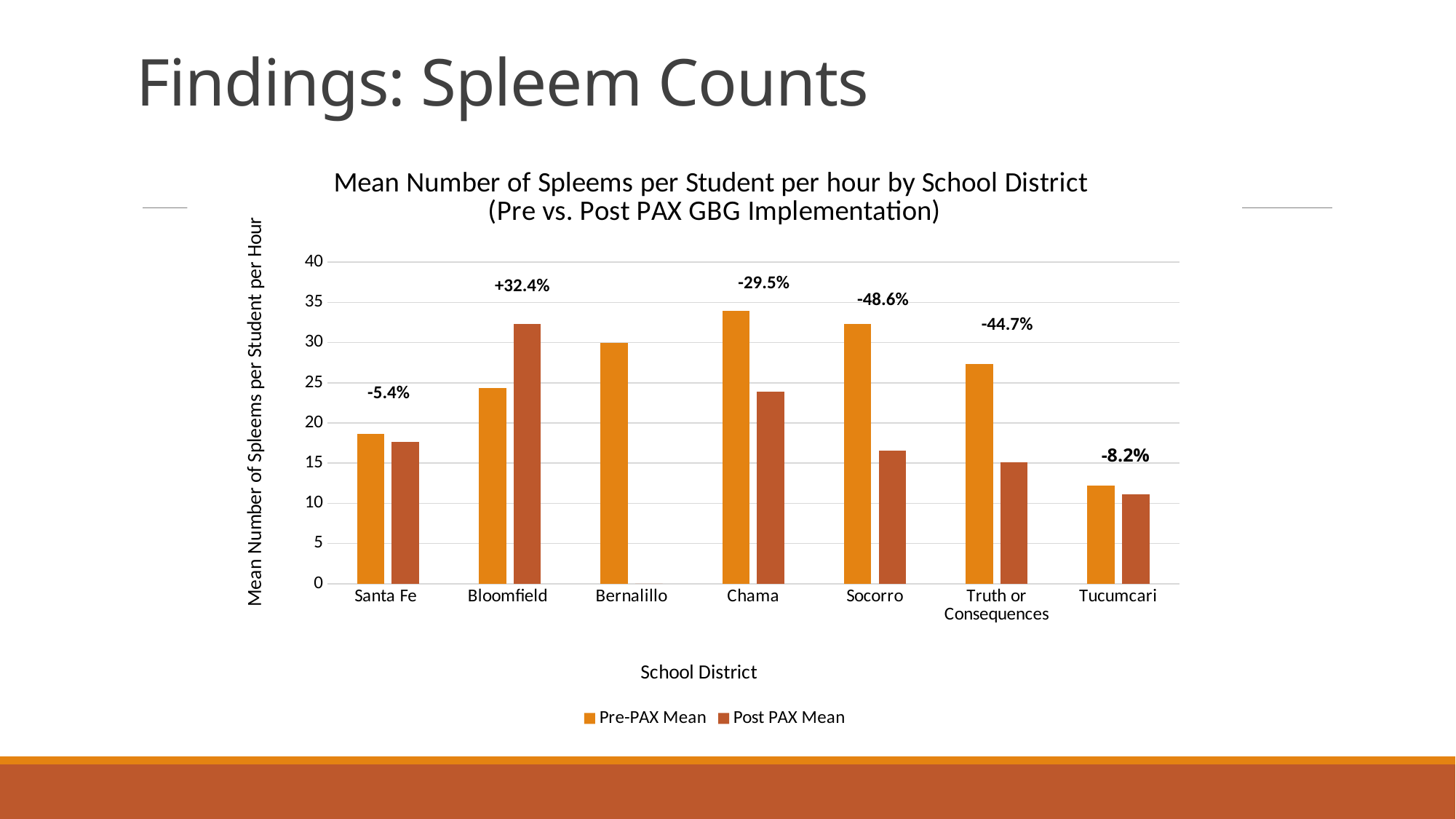
Which school district has the highest Post PAX Mean? Bloomfield Is the Post PAX Mean for Socorro greater or less than 20? less What percentage change is labelled above the bars for Bloomfield? +32.4% For Chama, which is larger: the Pre-PAX Mean or the Post PAX Mean? Pre-PAX Mean What kind of chart is shown on the slide? Bar chart How many school districts are shown on the x axis of the chart? 7 Which school district is the only one with a positive percentage change label? Bloomfield Which school district has the lowest Pre-PAX Mean? Tucumcari What percentage change is labelled above the bars for Socorro? -48.6% What percentage change is labelled above the bars for Truth or Consequences? -44.7% Is the Pre-PAX Mean for Chama greater or less than 30? greater How many series does the chart legend list? 2